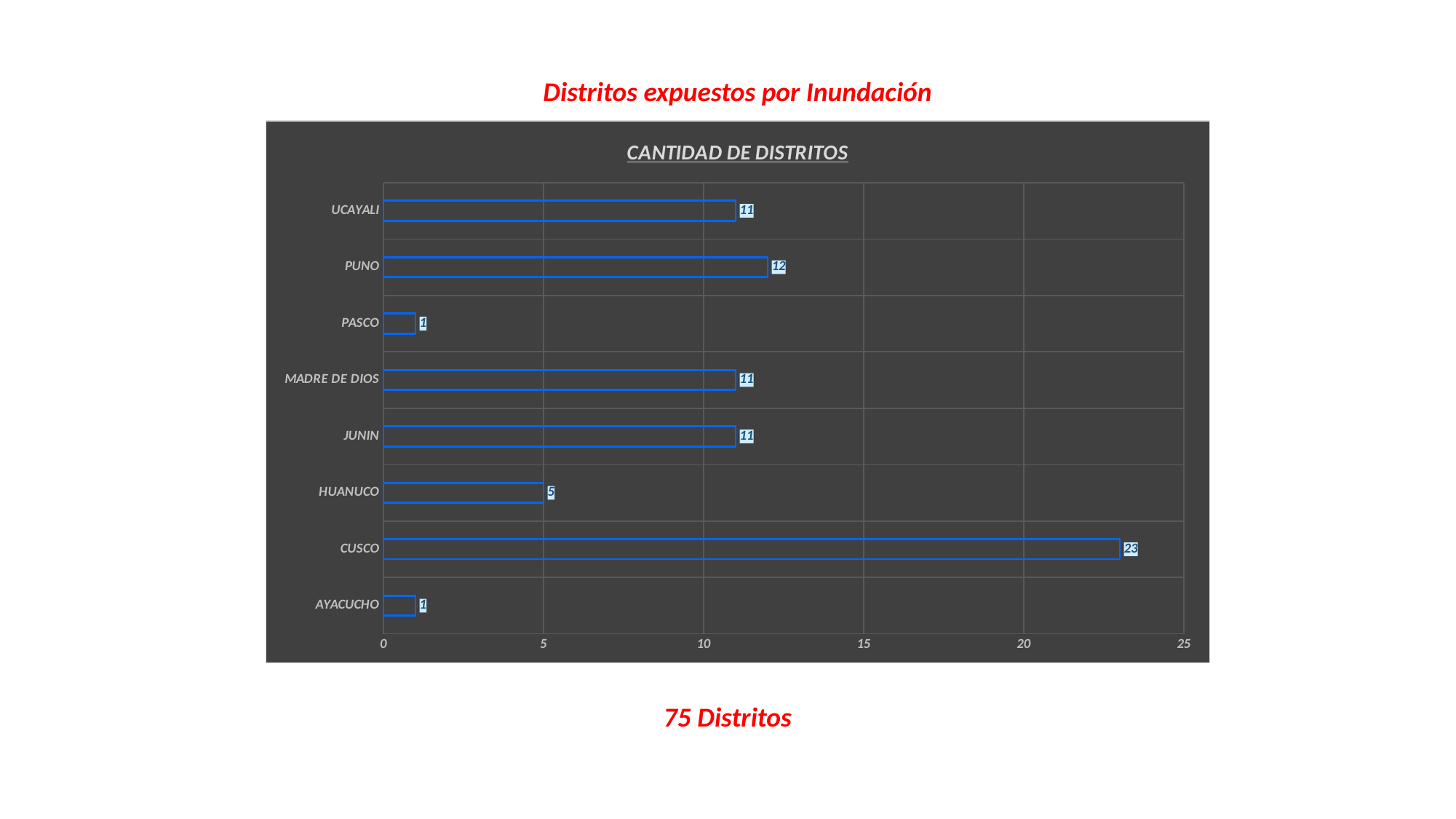
What is the difference between the values for UCAYALI and HUANUCO? 6 How many categories are shown in the chart? 8 What is the value for CUSCO? 23 What is the difference between the values for CUSCO and PUNO? 11 Is the value for CUSCO greater or less than 20? greater Which is larger, the value for PUNO or the value for JUNIN? PUNO What kind of chart is shown? bar chart What is the title of the chart? CANTIDAD DE DISTRITOS What is the value for HUANUCO? 5 Which category has the highest value? CUSCO What is the value for MADRE DE DIOS? 11 What is the value for PUNO? 12